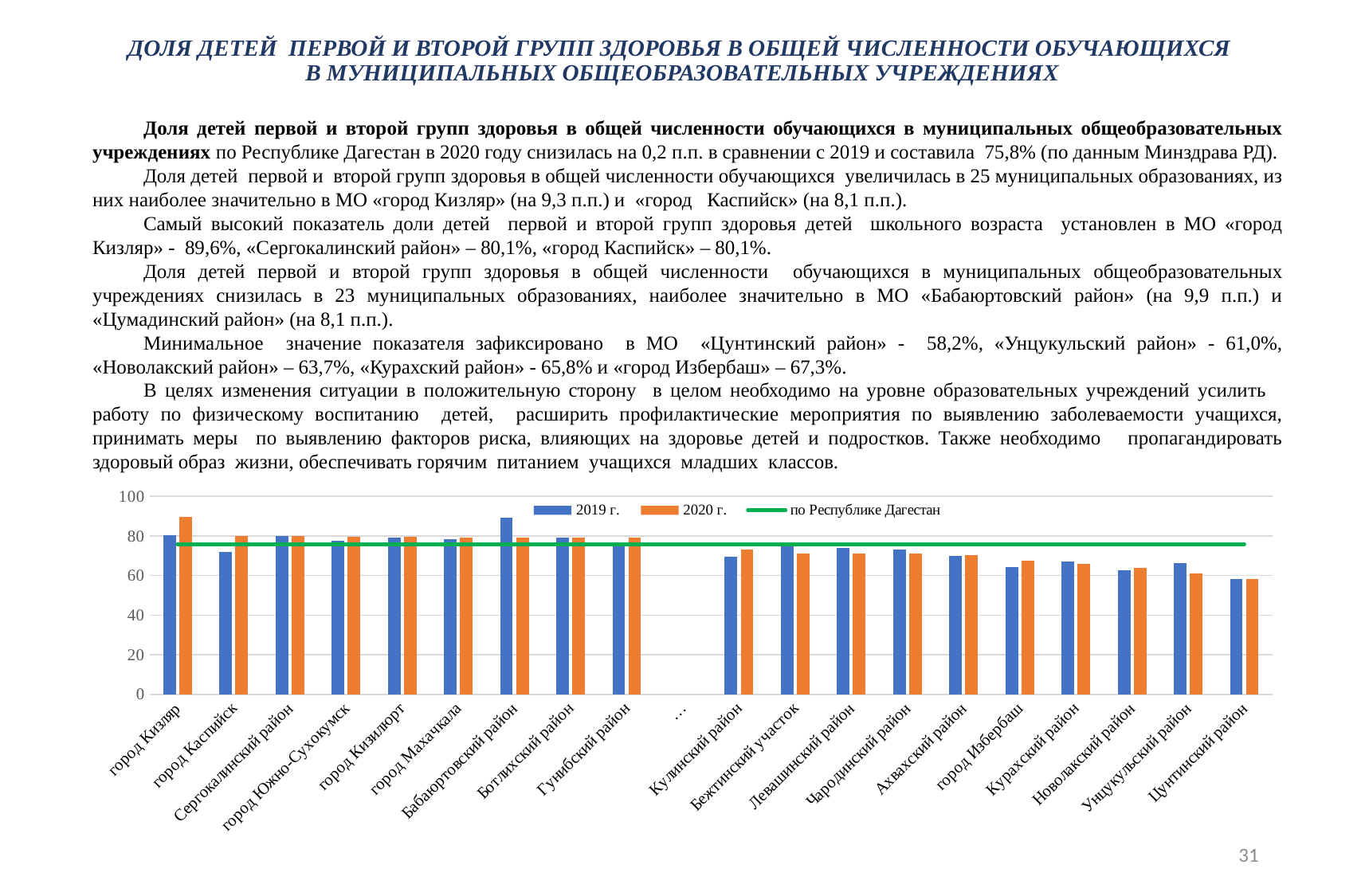
For Бабаюртовский район, which is larger: the 2019 г. bar or the 2020 г. bar? 2019 г. What kind of chart is shown on the slide? combination bar and line chart Is the 2019 г. value for Кулинский район greater or less than 80? less Which category has the lowest 2020 г. bar? Цунтинский район Which category has the highest 2020 г. bar? город Кизляр How many series does the chart legend list? 3 What does the green horizontal line in the chart represent, according to the legend? по Республике Дагестан Do the 2020 г. values generally rise or fall from left to right across the categories? fall Is the 2020 г. value for Цунтинский район greater or less than 60? less For город Кизляр, which is larger: the 2019 г. bar or the 2020 г. bar? 2020 г. Which category has the highest 2019 г. bar? Бабаюртовский район Is the 2020 г. value for город Кизляр greater or less than 80? greater